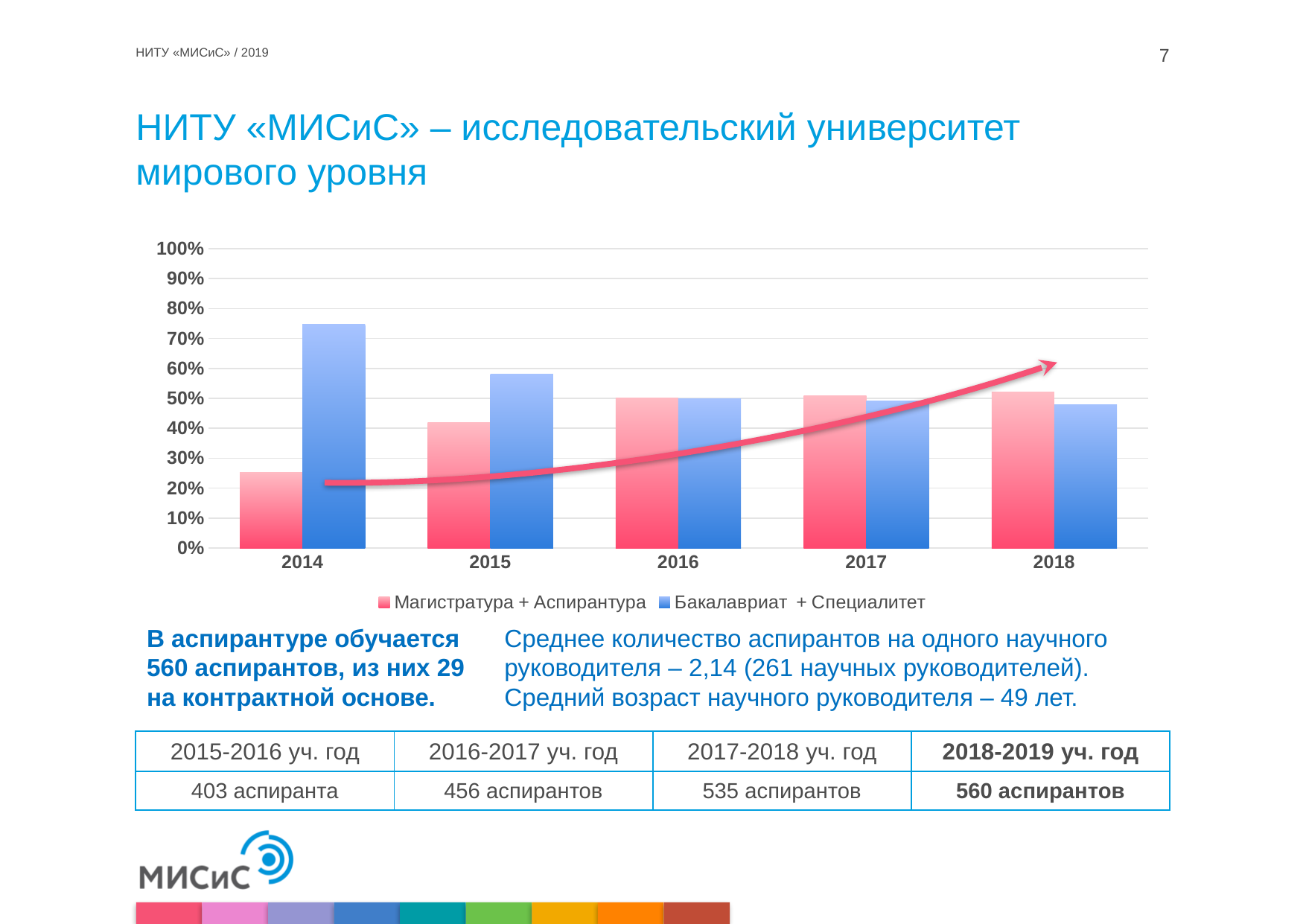
What kind of chart is shown on the slide? bar chart Is the value for Бакалавриат + Специалитет in 2014 greater or less than 70%? greater In which year is the value for Бакалавриат + Специалитет highest? 2014 Is the value for Бакалавриат + Специалитет in 2015 greater or less than 50%? greater How many years are shown on the x axis of the chart? 5 Is the value for Магистратура + Аспирантура in 2014 greater or less than 30%? less How many series does the chart legend list? 2 In which year is the value for Магистратура + Аспирантура lowest? 2014 What colour are the bars for the Магистратура + Аспирантура series? pink Does the value for Бакалавриат + Специалитет rise or fall from 2014 to 2018? fall In 2014, which series has the larger value: Магистратура + Аспирантура or Бакалавриат + Специалитет? Бакалавриат + Специалитет Does the value for Магистратура + Аспирантура rise or fall from 2014 to 2018? rise